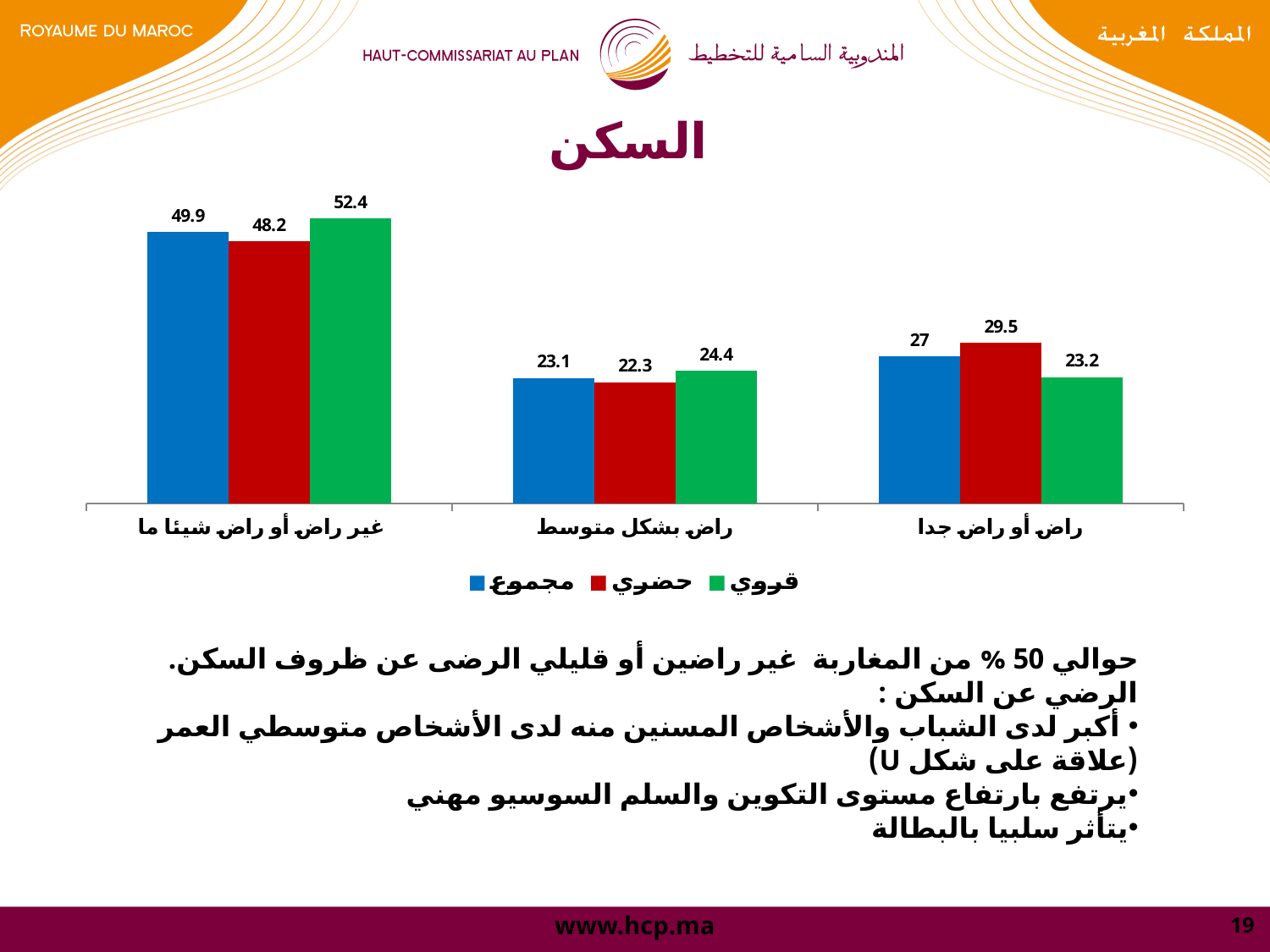
What type of chart is shown on the slide? bar chart What is the value of the مجموع series for the category غير راض أو راض شيئا ما? 49.9 How many categories are shown on the x axis? 3 Which series has the lowest value in the category راض أو راض جدا? قروي Which colour represents the حضري series? red What is the title of the chart? السكن What is the value of the حضري series for the category راض أو راض جدا? 29.5 Which is larger in the category راض أو راض جدا: the مجموع value or the حضري value? حضري Which series has the highest value in the category غير راض أو راض شيئا ما? قروي What is the difference between the قروي and حضري values in the category غير راض أو راض شيئا ما? 4.2 How many series does the legend list? 3 What is the value of the قروي series for the category راض بشكل متوسط? 24.4